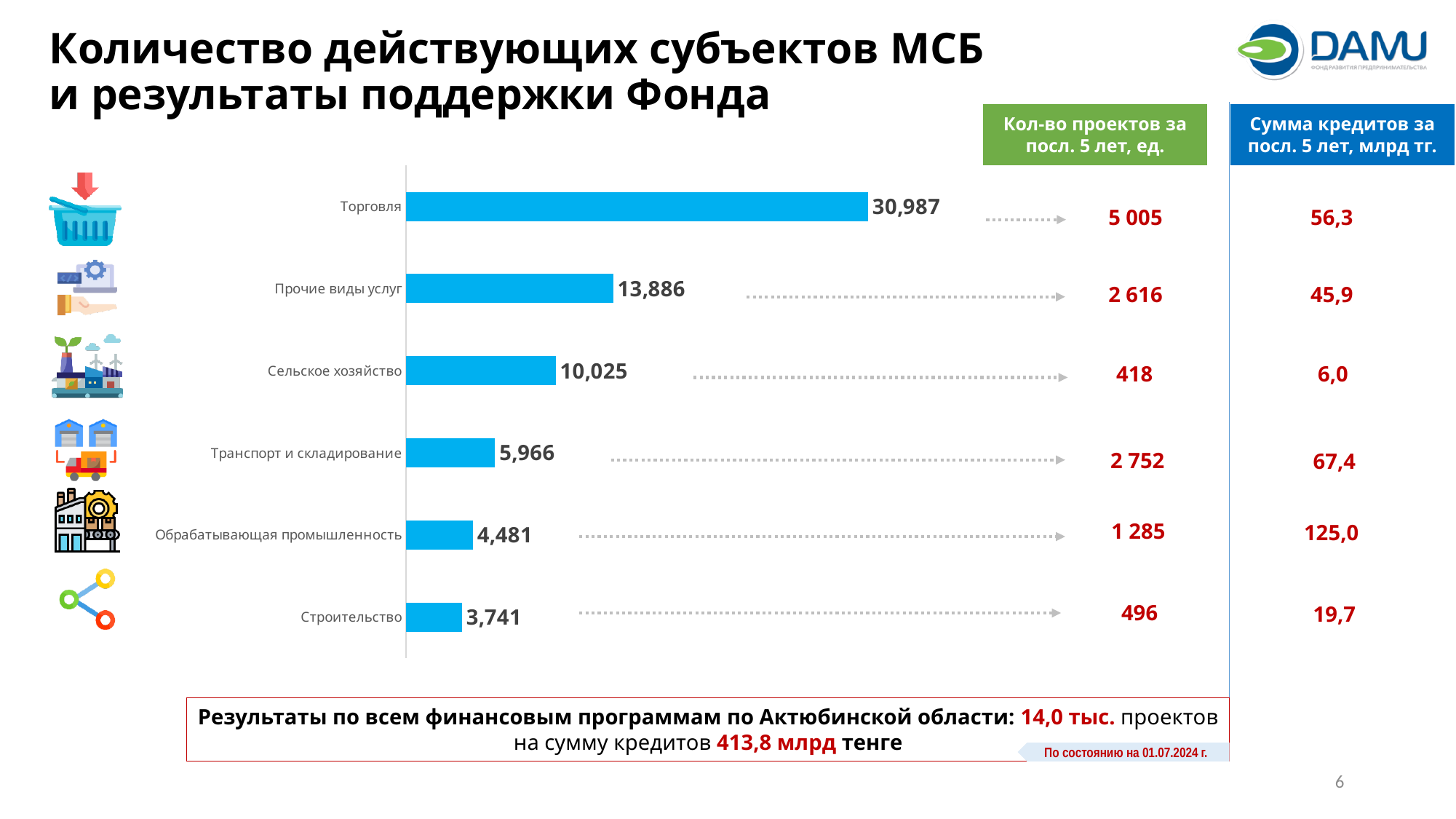
What is the value for Обрабатывающая промышленность? 4,481 Which is larger, the value for Прочие виды услуг or the value for Сельское хозяйство? Прочие виды услуг Which category has the highest value? Торговля What is the value for Строительство? 3,741 Which category has the lowest value? Строительство What is the difference between the values for Торговля and Прочие виды услуг? 17,101 What is the value for Торговля? 30,987 What is the difference between the values for Сельское хозяйство and Транспорт и складирование? 4,059 What colour are the bars in the chart? Blue What kind of chart is shown on the slide? Bar chart How many categories are shown in the bar chart? 6 What is the value for Сельское хозяйство? 10,025